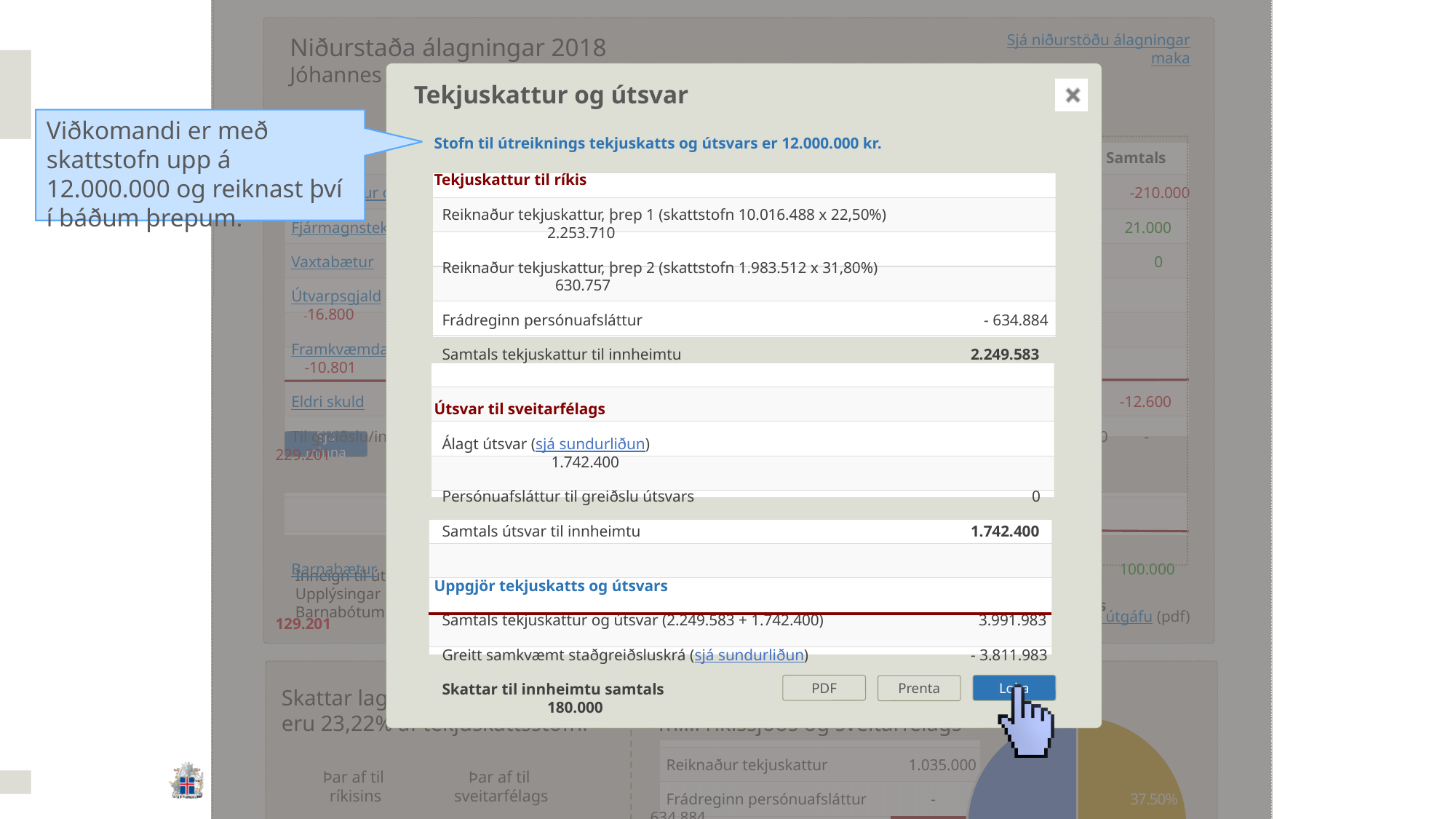
What kind of chart is partially visible at the bottom right of the slide, behind the dialog box? pie chart What are the two colours of the slices visible in the pie chart at the bottom right of the slide? blue-grey and gold In the pie chart at the bottom right of the slide, what percentage label is printed on the gold-coloured slice? 37.50% How many slices of the pie chart at the bottom right of the slide have a visible percentage label? 1